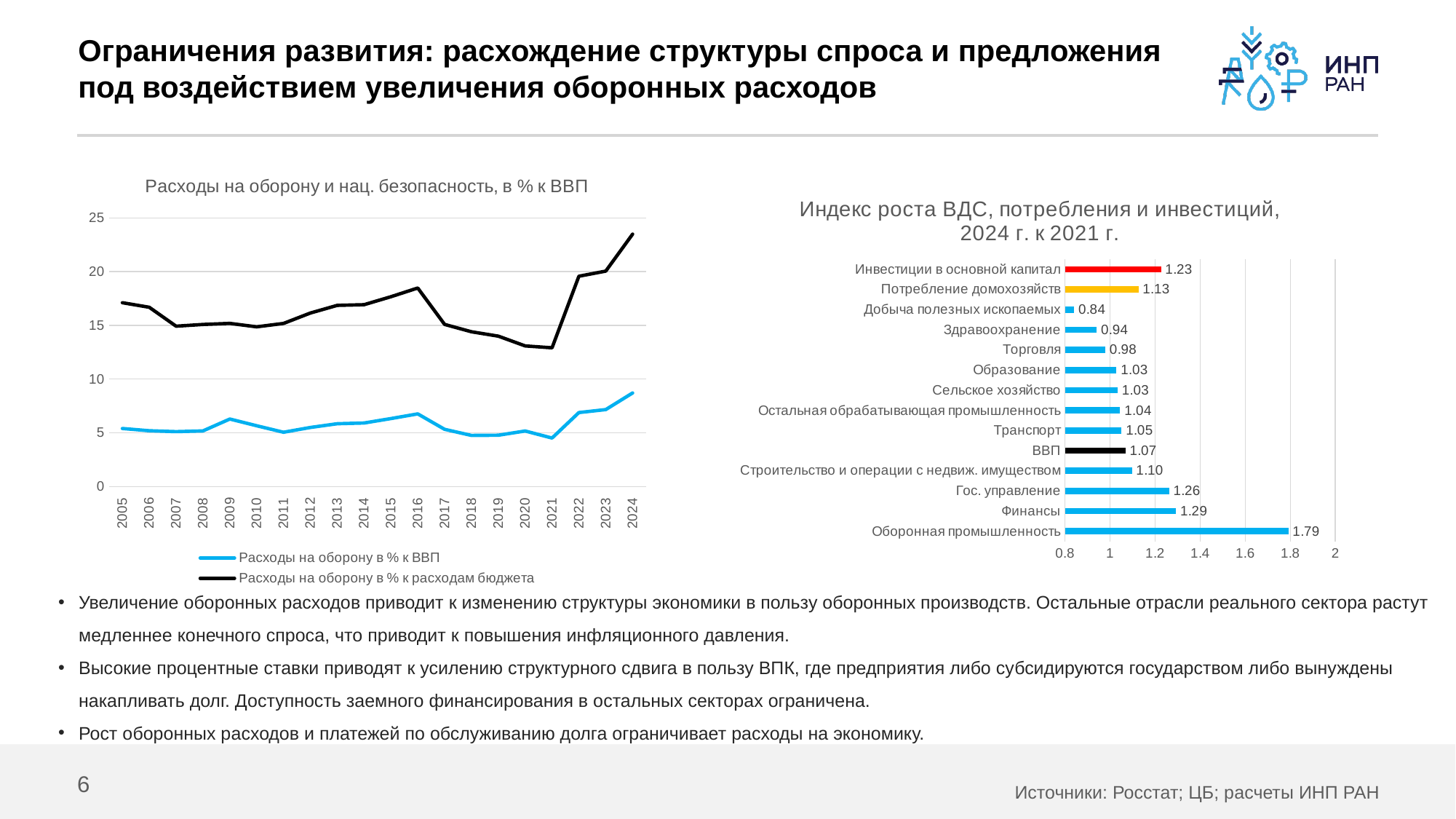
In the chart 'Индекс роста ВДС, потребления и инвестиций, 2024 г. к 2021 г.', which category has the lowest value? Добыча полезных ископаемых In the chart 'Индекс роста ВДС, потребления и инвестиций, 2024 г. к 2021 г.', which category has the highest value? Оборонная промышленность In the chart 'Индекс роста ВДС, потребления и инвестиций, 2024 г. к 2021 г.', what is the value for ВВП? 1.07 In the chart 'Индекс роста ВДС, потребления и инвестиций, 2024 г. к 2021 г.', what is the value for Инвестиции в основной капитал? 1.23 In the chart 'Индекс роста ВДС, потребления и инвестиций, 2024 г. к 2021 г.', what is the difference between the values for Оборонная промышленность and ВВП? 0.72 How many series does the legend of the chart 'Расходы на оборону и нац. безопасность, в % к ВВП' list? 2 In the chart 'Расходы на оборону и нац. безопасность, в % к ВВП', does the series 'Расходы на оборону в % к расходам бюджета' rise or fall between 2016 and 2021? fall In the chart 'Индекс роста ВДС, потребления и инвестиций, 2024 г. к 2021 г.', which is larger: Финансы or Гос. управление? Финансы In the chart 'Расходы на оборону и нац. безопасность, в % к ВВП', is the value of 'Расходы на оборону в % к расходам бюджета' for 2024 greater or less than 20? greater How many categories are shown in the chart 'Индекс роста ВДС, потребления и инвестиций, 2024 г. к 2021 г.'? 14 In the chart 'Расходы на оборону и нац. безопасность, в % к ВВП', is the value of 'Расходы на оборону в % к ВВП' for 2024 greater or less than 5? greater What kind of chart is 'Индекс роста ВДС, потребления и инвестиций, 2024 г. к 2021 г.'? Bar chart